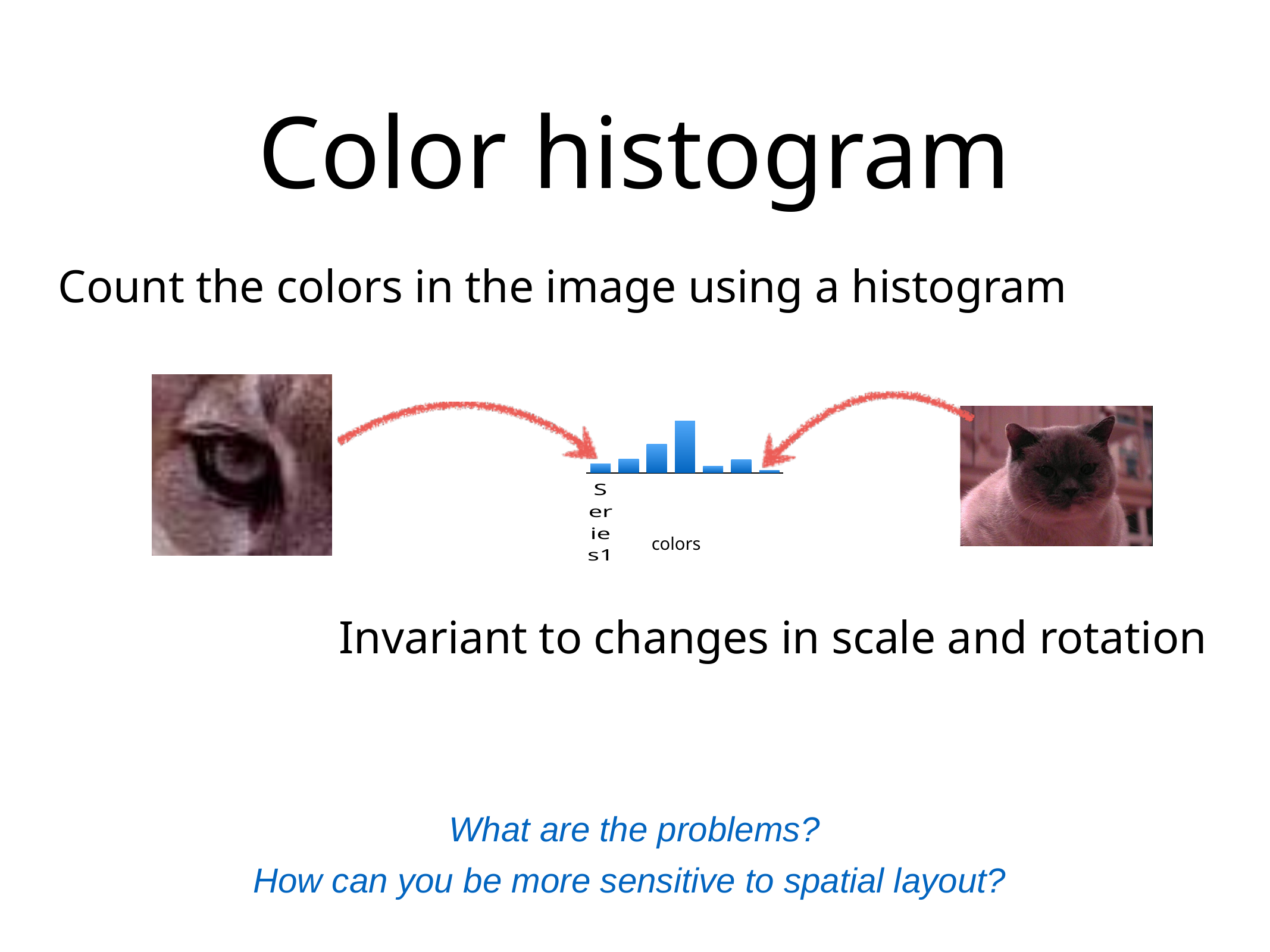
Is the third bar from the left taller or shorter than the fourth bar? shorter Which bar in the chart is the shortest, counting from the left? the seventh (rightmost) bar Do the bar heights rise or fall from the first bar to the fourth bar? rise What kind of chart is shown on the slide? bar chart How many bars does the chart contain? 7 Is the sixth bar from the left taller or shorter than the fifth bar? taller What is the label on the chart's horizontal axis? colors Which bar in the chart is the tallest, counting from the left? the fourth bar